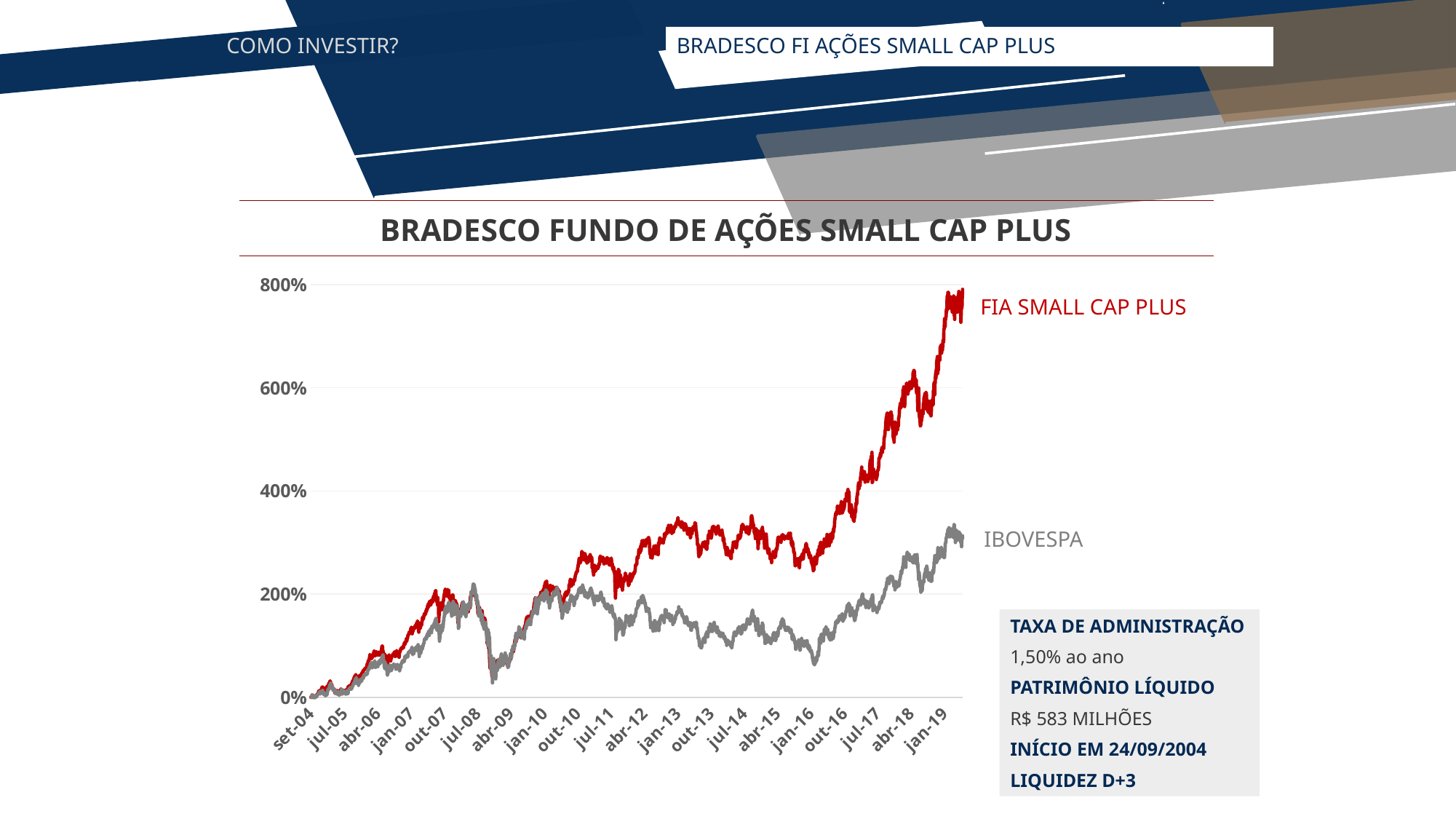
Which series is drawn in red? FIA SMALL CAP PLUS Around jan-16, is the value for IBOVESPA greater or less than 200%? less What is the title of the chart? BRADESCO FUNDO DE AÇÕES SMALL CAP PLUS How many date labels are shown on the x axis? 20 At the end of the period (jan-19), is the value for FIA SMALL CAP PLUS greater or less than 600%? greater Overall, does the FIA SMALL CAP PLUS line rise or fall from set-04 to jan-19? rise What is the highest value shown on the y axis? 800% Around jan-13, is the value for FIA SMALL CAP PLUS greater or less than 200%? greater At the end of the period, which series has the higher value, FIA SMALL CAP PLUS or IBOVESPA? FIA SMALL CAP PLUS How many series are plotted on the chart? 2 What kind of chart is shown on the slide? line chart